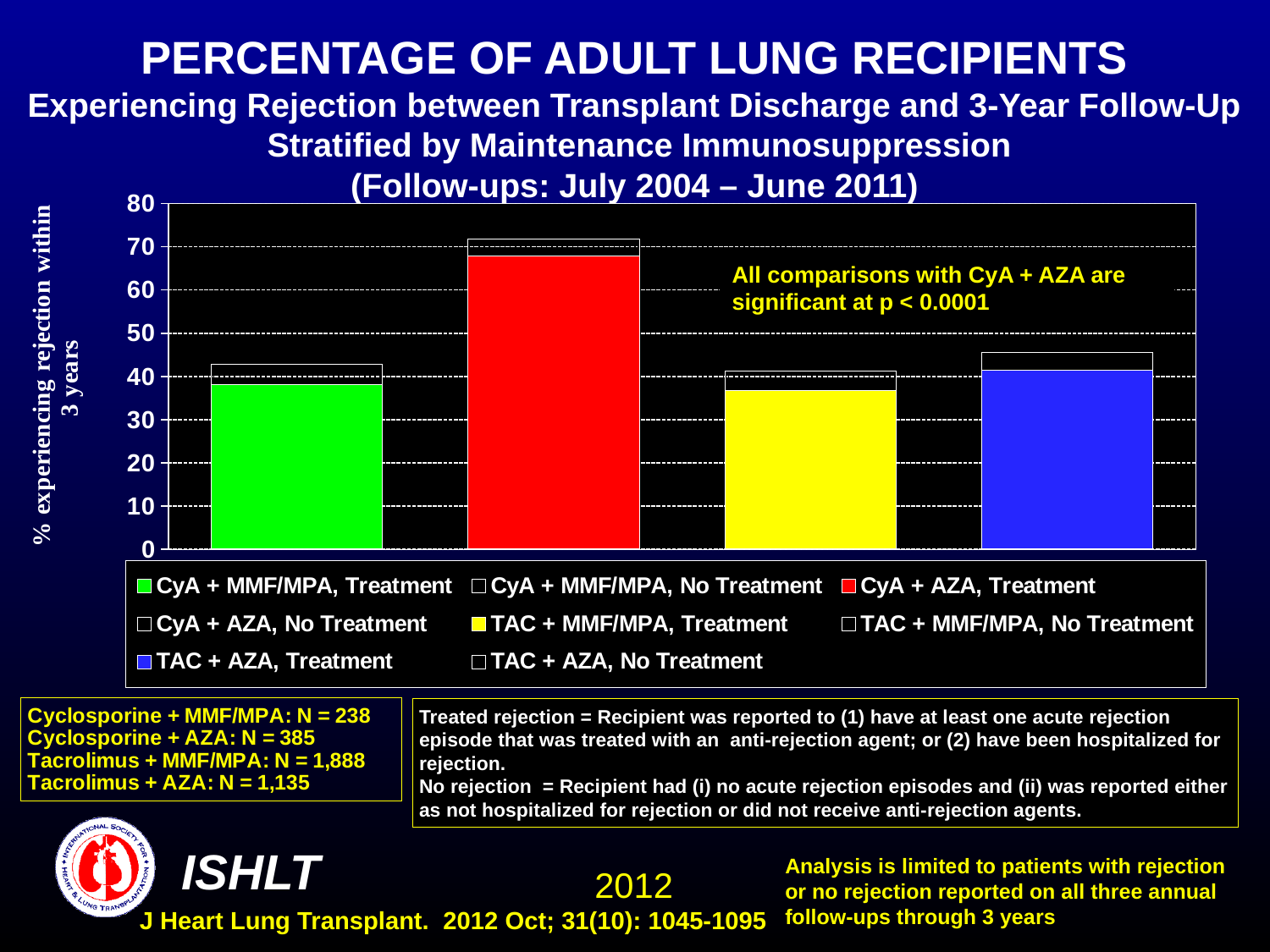
Is the value for CyA + AZA, Treatment greater or less than 60? greater Which immunosuppression group has the highest percentage of recipients experiencing treated rejection? CyA + AZA, Treatment How many series does the legend list? 8 How many bars (immunosuppression groups) are plotted in the chart? 4 Is the value for CyA + MMF/MPA, Treatment greater or less than 50? less According to the annotation on the chart, at what p-value are all comparisons with CyA + AZA significant? p < 0.0001 Which is larger, the treated rejection percentage for CyA + AZA or for CyA + MMF/MPA? CyA + AZA Is the value for TAC + AZA, Treatment greater or less than 30? greater What kind of chart is shown on the slide? Stacked bar chart What colour is the bar segment for TAC + MMF/MPA, Treatment? Yellow Which is larger, the treated rejection percentage for CyA + AZA or for TAC + AZA? CyA + AZA